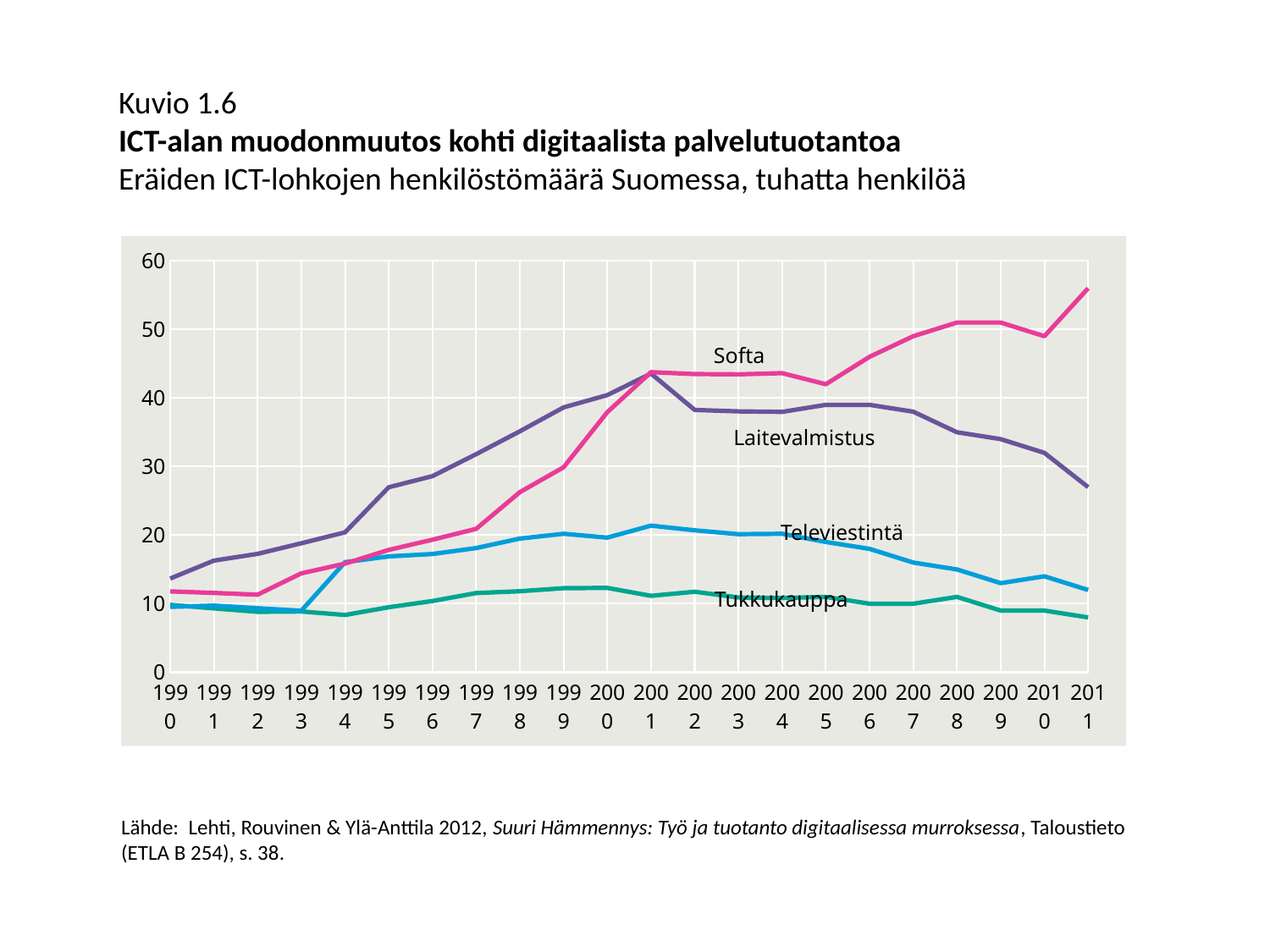
Is the value for Laitevalmistus in 2011 greater or less than 30? less Which series has the lowest value in 2011? Tukkukauppa How many data series are plotted in the chart? 4 In 2005, which is larger: the value for Softa or the value for Laitevalmistus? Softa What is the bold title of the chart on the slide? ICT-alan muodonmuutos kohti digitaalista palvelutuotantoa Is the value for Softa in 2011 greater or less than 50? greater How many years are shown along the x axis of the chart? 22 Is the value for Televiestintä in 2008 greater or less than 20? less What kind of chart is shown on the slide? line chart Which series has the highest value in 2011? Softa Does the Softa series rise or fall overall between 1990 and 2011? rise Does the Laitevalmistus series rise or fall between 2001 and 2011? fall